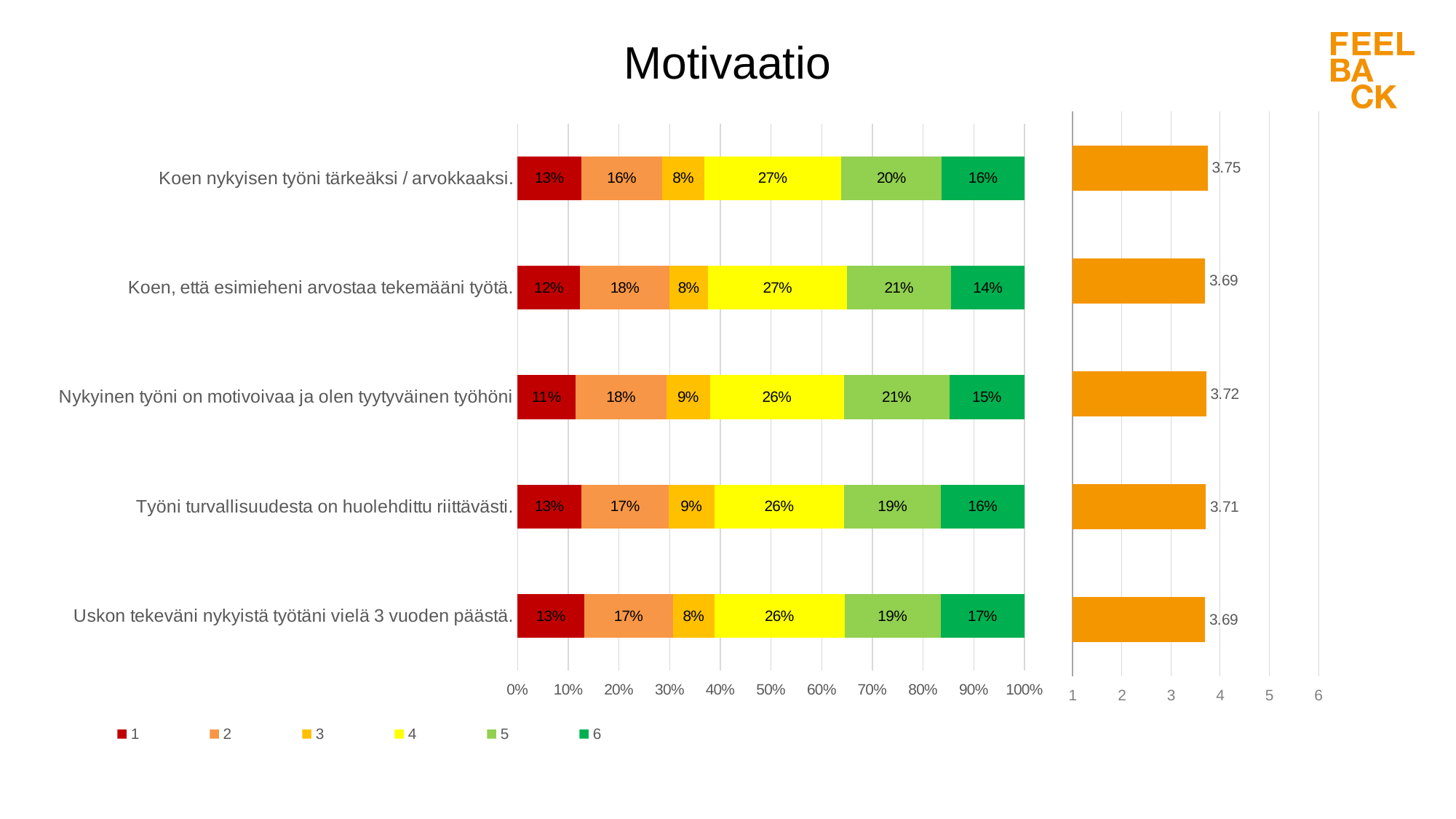
How many series does the legend of the stacked bar chart on the left list? 6 In the stacked bar chart on the left, what percentage of responses for "Koen nykyisen työni tärkeäksi / arvokkaaksi." are in category 6? 16% In the bar chart on the right, what is the value shown for "Koen nykyisen työni tärkeäksi / arvokkaaksi."? 3.75 What is the title of the slide? Motivaatio In the bar chart on the right, which statement has the highest value? Koen nykyisen työni tärkeäksi / arvokkaaksi. What kind of chart is the chart on the left? Stacked bar chart How many statements (categories) are plotted in the stacked bar chart on the left? 5 In the bar chart on the right, what is the value shown for "Nykyinen työni on motivoivaa ja olen tyytyväinen työhöni"? 3.72 In the bar chart on the right, is the value for "Työni turvallisuudesta on huolehdittu riittävästi." greater or less than 3? greater In the bar chart on the right, what is the difference between the value for "Koen nykyisen työni tärkeäksi / arvokkaaksi." and the value for "Uskon tekeväni nykyistä työtäni vielä 3 vuoden päästä."? 0.06 In the stacked bar chart on the left, what percentage of responses for "Nykyinen työni on motivoivaa ja olen tyytyväinen työhöni" are in category 1? 11% In the stacked bar chart on the left, is the category 4 share larger for "Koen, että esimieheni arvostaa tekemääni työtä." or for "Työni turvallisuudesta on huolehdittu riittävästi."? Koen, että esimieheni arvostaa tekemääni työtä.